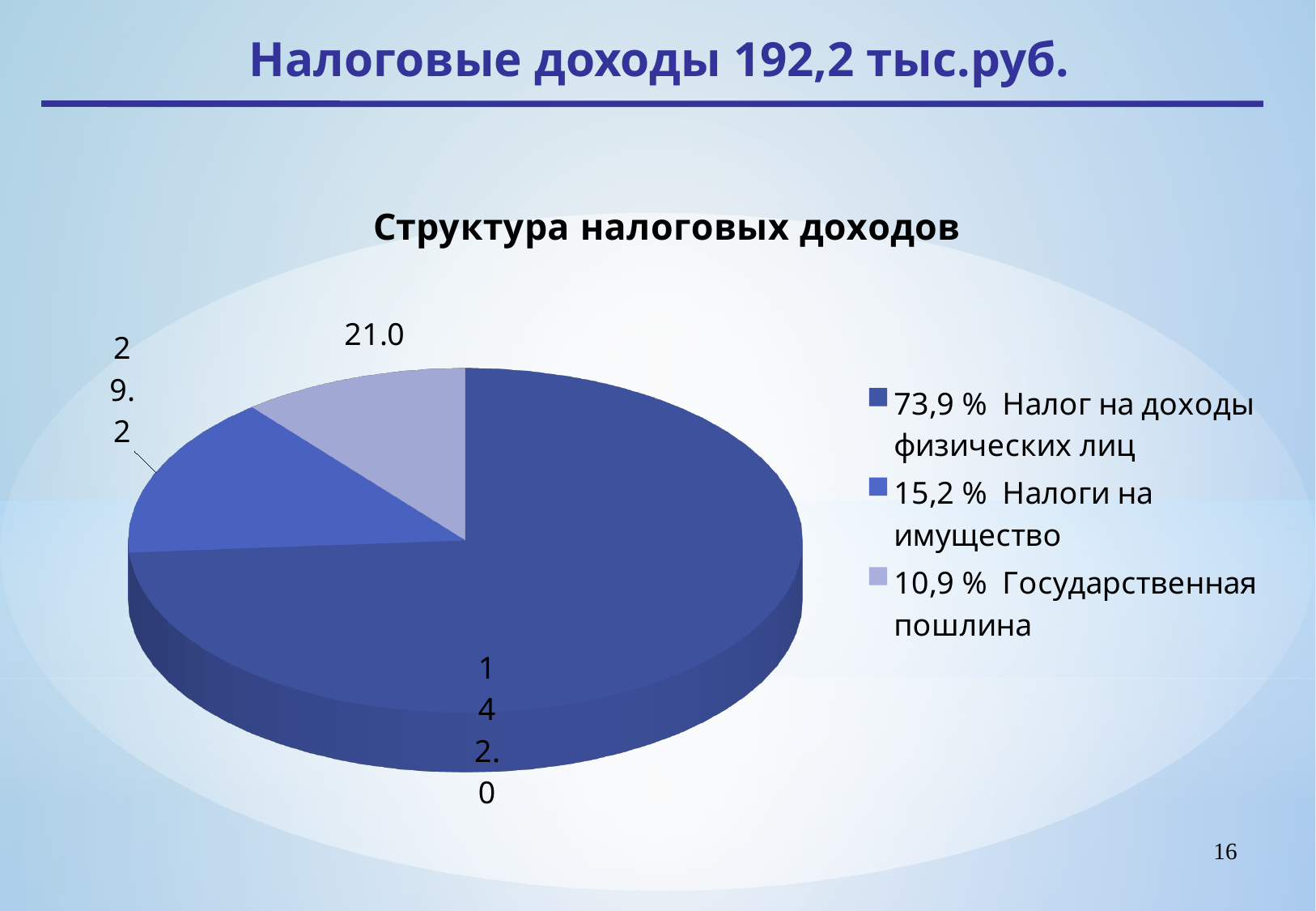
Which category has the smallest slice of the pie? Государственная пошлина What is the title of the chart? Структура налоговых доходов How many entries does the legend list? 3 Which is larger, the value for Налоги на имущество or the value for Государственная пошлина? Налоги на имущество What is the value shown for Налоги на имущество? 29.2 What is the value shown for Налог на доходы физических лиц? 142.0 What share of the pie does Государственная пошлина represent, according to the legend? 10,9 % What is the value shown for Государственная пошлина? 21.0 Which category has the largest slice of the pie? Налог на доходы физических лиц What kind of chart is shown on the slide? pie chart How many slices does the pie chart have? 3 What is the difference between the values for Налоги на имущество and Государственная пошлина? 8.2